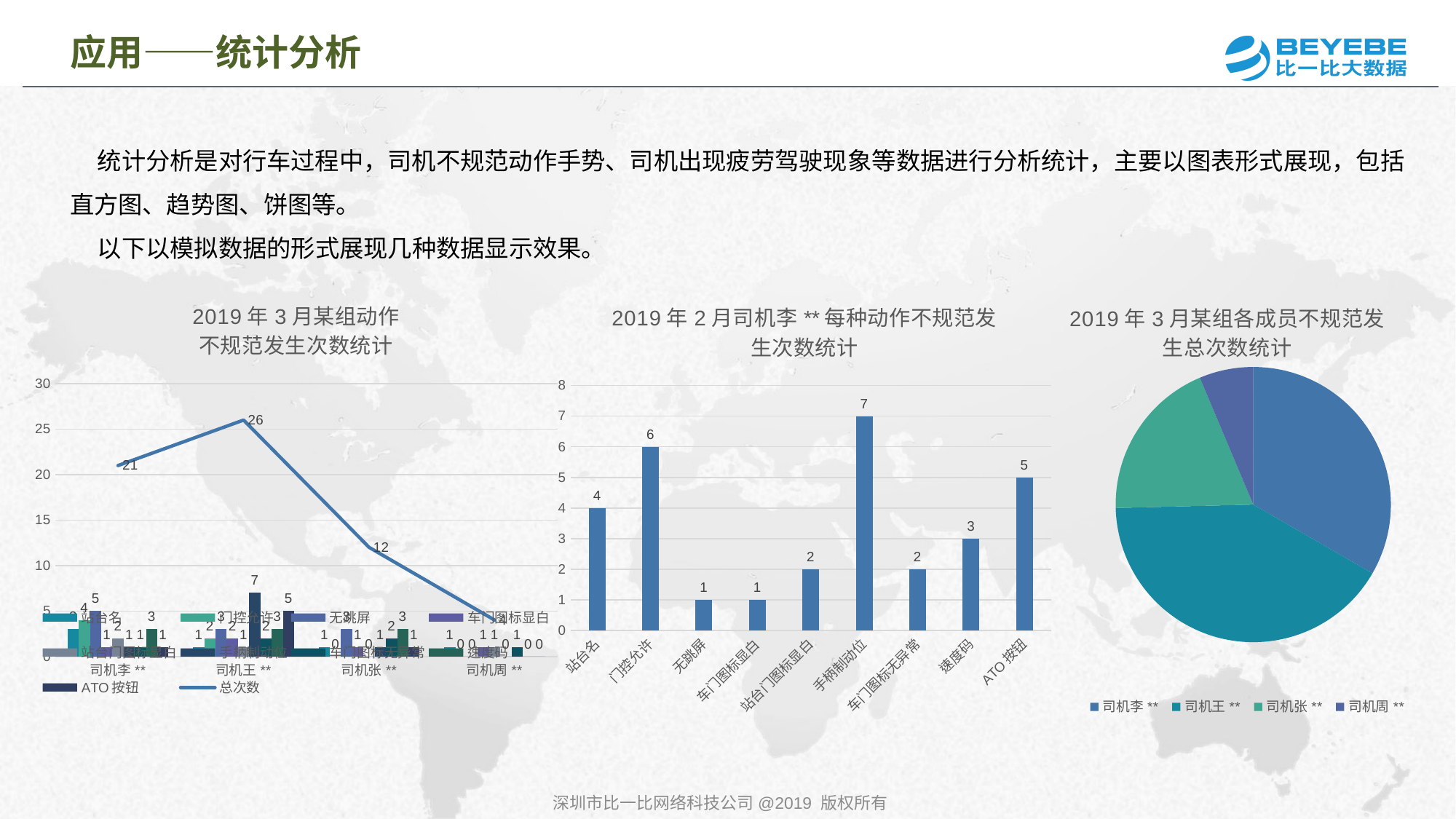
How many categories are shown on the x axis of the middle chart (2019年2月司机李**每种动作不规范发生次数统计)? 9 What type of chart is the right chart titled 2019年3月某组各成员不规范发生总次数统计? pie chart In the middle chart (2019年2月司机李**每种动作不规范发生次数统计), which category has the highest value? 手柄制动位 In the middle chart (2019年2月司机李**每种动作不规范发生次数统计), what is the value for 门控允许? 6 In the left chart (2019年3月某组动作不规范发生次数统计), does the 总次数 line rise or fall from 司机王** to 司机周**? fall In the right pie chart (2019年3月某组各成员不规范发生总次数统计), which member has the smallest slice? 司机周** In the middle chart (2019年2月司机李**每种动作不规范发生次数统计), what is the difference between the values for 门控允许 and 站台名? 2 In the middle chart (2019年2月司机李**每种动作不规范发生次数统计), what is the value for 手柄制动位? 7 In the left chart (2019年3月某组动作不规范发生次数统计), what is the 总次数 value for 司机李**? 21 What type of chart is the middle chart titled 2019年2月司机李**每种动作不规范发生次数统计? bar chart In the middle chart (2019年2月司机李**每种动作不规范发生次数统计), which is larger, the value for ATO按钮 or the value for 速度码? ATO按钮 In the left chart (2019年3月某组动作不规范发生次数统计), what is the 总次数 value for 司机王**? 26